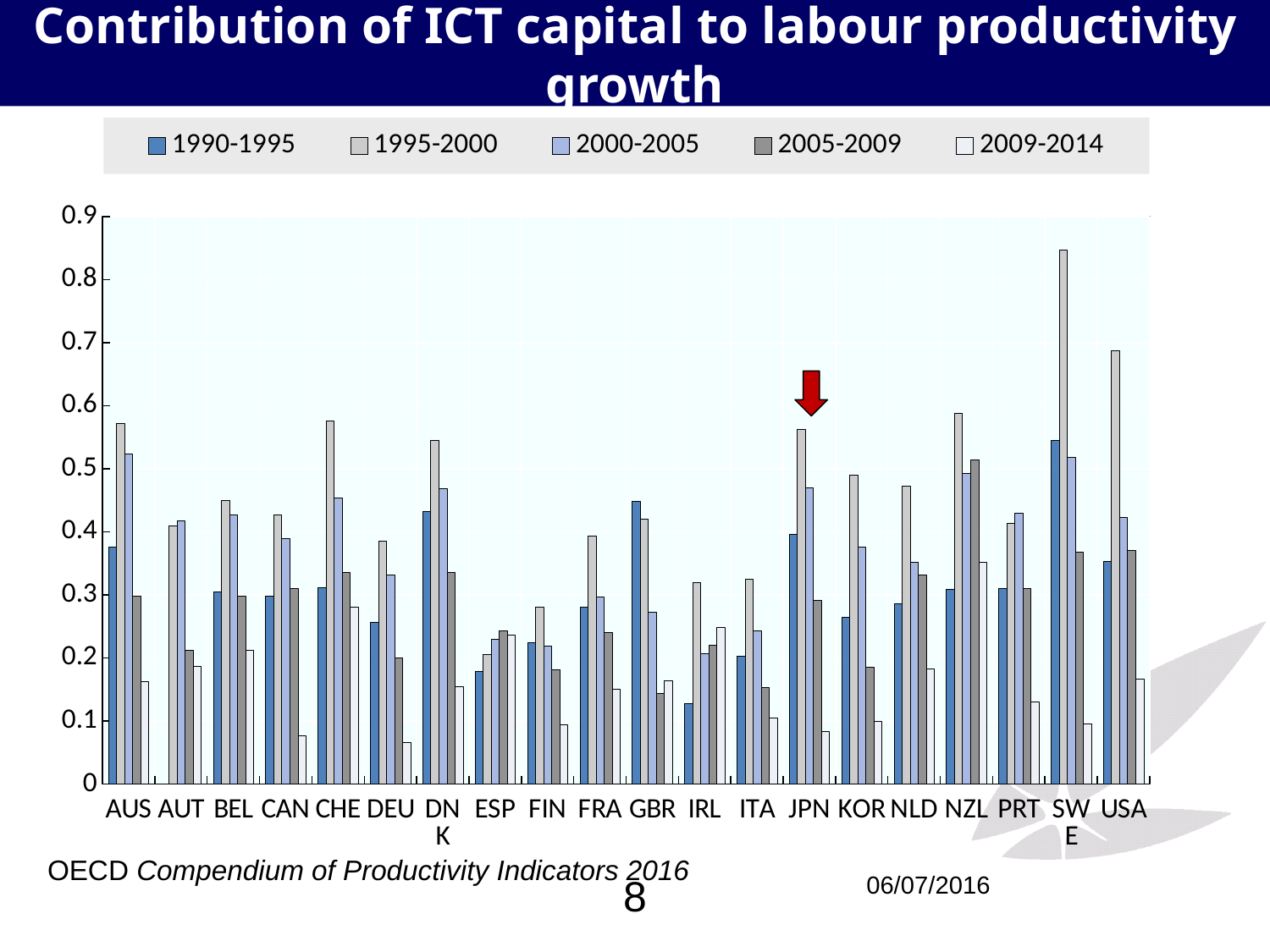
Is the 2009-2014 value for CAN greater or less than 0.1? less Is the 1990-1995 value for ESP greater or less than 0.2? less Which country does the red arrow on the chart point to? JPN Which is larger, the 1990-1995 value for GBR or the 1990-1995 value for IRL? GBR How many series does the legend list? 5 Is the 1995-2000 value for JPN greater or less than 0.5? greater How many countries are shown on the x axis? 20 Which country has the highest 1995-2000 bar? SWE Which country has the highest 1990-1995 bar? SWE Which is larger, the 1995-2000 value for SWE or the 1995-2000 value for USA? SWE What kind of chart is shown on the slide? bar chart